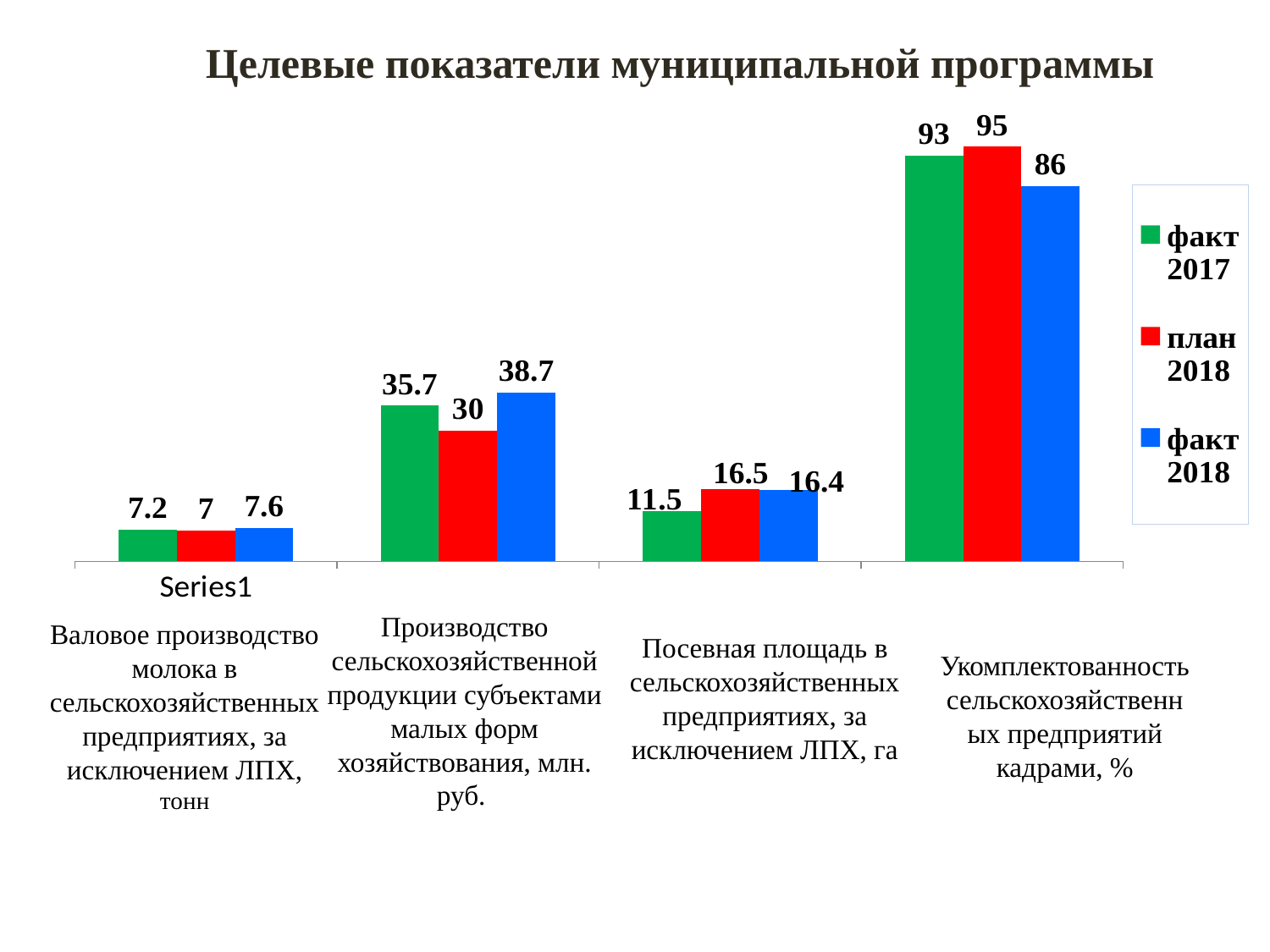
Which series has the highest value for 'Укомплектованность сельскохозяйственных предприятий кадрами, %'? план 2018 What is the 'план 2018' value for 'Производство сельскохозяйственной продукции субъектами малых форм хозяйствования, млн. руб.'? 30 Which series has the lowest value for 'Производство сельскохозяйственной продукции субъектами малых форм хозяйствования, млн. руб.'? план 2018 What is the 'факт 2017' value for 'Валовое производство молока в сельскохозяйственных предприятиях, за исключением ЛПХ, тонн'? 7.2 What is the 'факт 2018' value for 'Посевная площадь в сельскохозяйственных предприятиях, за исключением ЛПХ, га'? 16.4 Which is larger for 'Посевная площадь в сельскохозяйственных предприятиях, за исключением ЛПХ, га': 'факт 2017' or 'план 2018'? план 2018 What is the title of the chart? Целевые показатели муниципальной программы How many series does the legend list? 3 How many categories (groups of bars) are shown in the chart? 4 What kind of chart is shown on the slide? bar chart What is the difference between 'план 2018' and 'факт 2018' for 'Укомплектованность сельскохозяйственных предприятий кадрами, %'? 9 What colour are the 'факт 2018' bars? blue